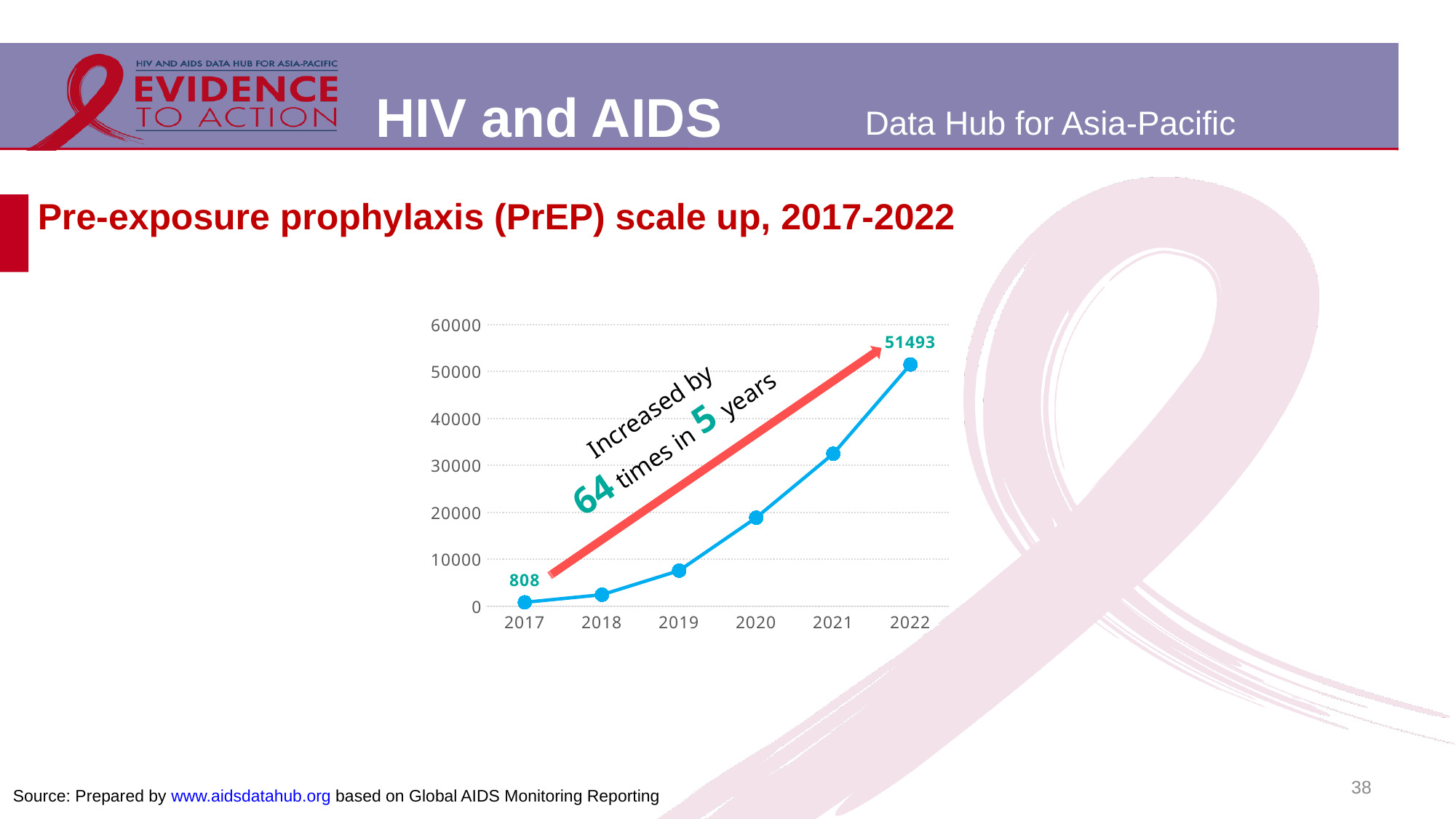
What is the difference between the 2022 value and the 2017 value? 50685 Which year has the lowest value on the chart? 2017 What is the value for 2022 on the PrEP scale up chart? 51493 How many years are plotted on the chart? 6 What kind of chart is shown on the slide? Line chart Do the values rise or fall from 2017 to 2022? Rise Is the value for 2021 greater or less than 30000? greater What is the value for 2017 on the PrEP scale up chart? 808 Which year has the highest value on the chart? 2022 Which is larger, the value for 2021 or the value for 2020? 2021 According to the annotation on the chart, by how many times did the value increase in 5 years? 64 times